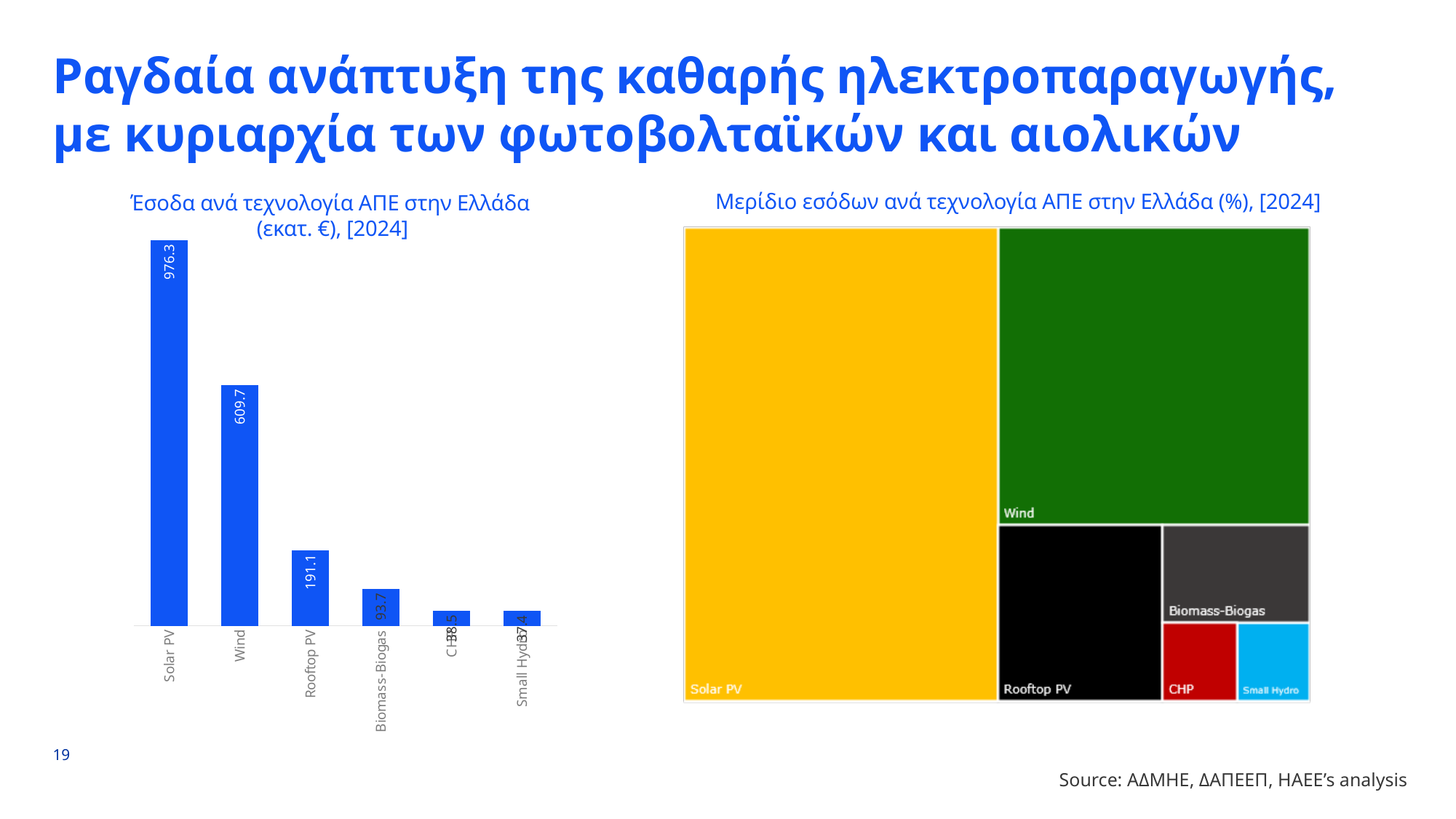
In the right chart (Μερίδιο εσόδων ανά τεχνολογία ΑΠΕ στην Ελλάδα), what colour is the Wind block? Green In the left chart (Έσοδα ανά τεχνολογία ΑΠΕ στην Ελλάδα), what is the value for Rooftop PV? 191.1 In the left chart (Έσοδα ανά τεχνολογία ΑΠΕ στην Ελλάδα), what is the value for Solar PV? 976.3 What kind of chart is the left chart (Έσοδα ανά τεχνολογία ΑΠΕ στην Ελλάδα)? Bar chart In the left chart (Έσοδα ανά τεχνολογία ΑΠΕ στην Ελλάδα), do the values rise or fall from left to right? Fall In the left chart (Έσοδα ανά τεχνολογία ΑΠΕ στην Ελλάδα), which technology has the highest revenue? Solar PV In the left chart (Έσοδα ανά τεχνολογία ΑΠΕ στην Ελλάδα), which is larger, Rooftop PV or Biomass-Biogas? Rooftop PV In the left chart (Έσοδα ανά τεχνολογία ΑΠΕ στην Ελλάδα), how many technologies are shown? 6 In the left chart (Έσοδα ανά τεχνολογία ΑΠΕ στην Ελλάδα), what is the value for Biomass-Biogas? 93.7 In the right chart (Μερίδιο εσόδων ανά τεχνολογία ΑΠΕ στην Ελλάδα), which technology has the largest share? Solar PV In the left chart (Έσοδα ανά τεχνολογία ΑΠΕ στην Ελλάδα), what is the value for Wind? 609.7 In the left chart (Έσοδα ανά τεχνολογία ΑΠΕ στην Ελλάδα), what is the difference between the Solar PV and Wind values? 366.6